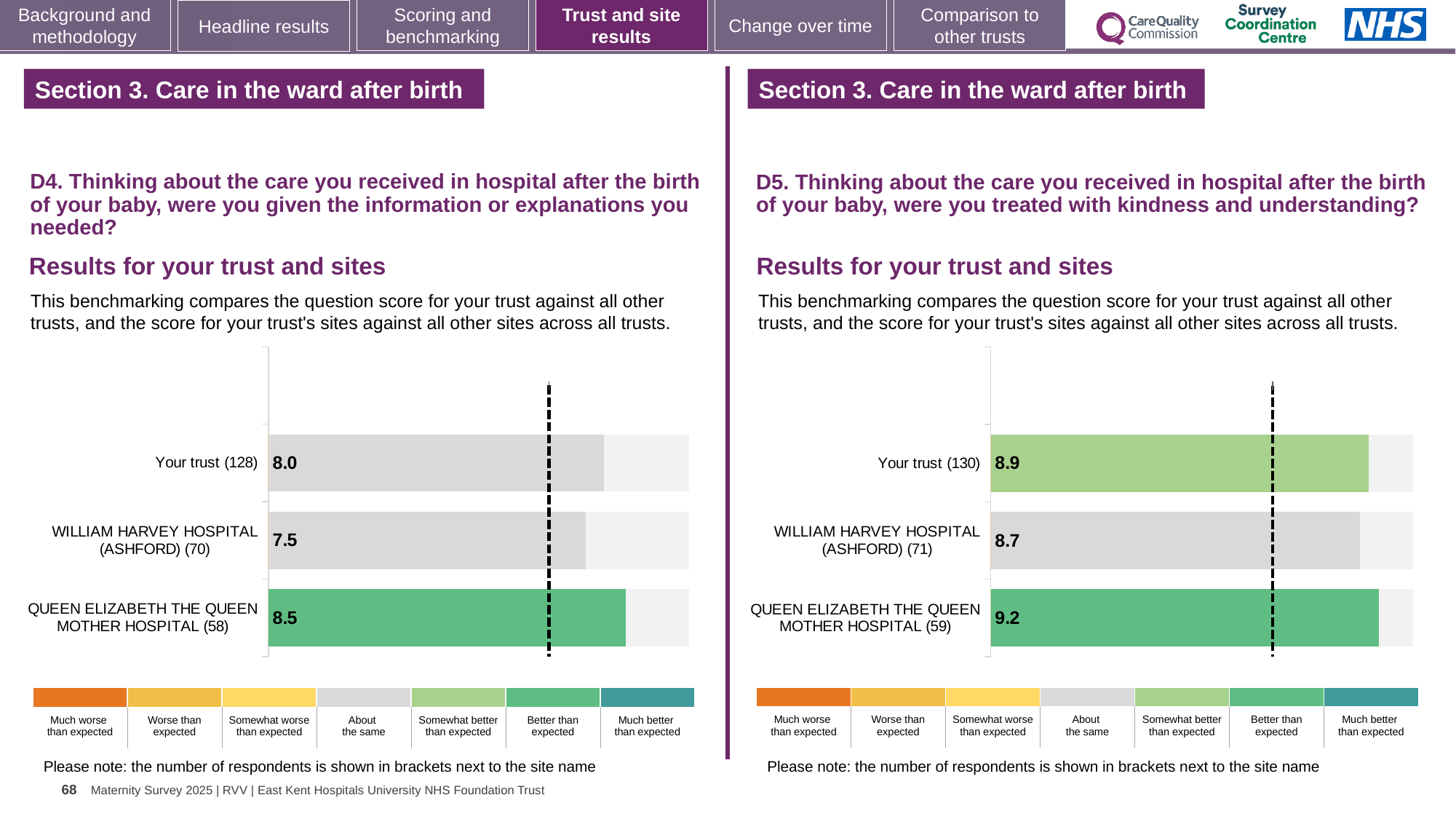
In the D4 chart on the left, what is the score for WILLIAM HARVEY HOSPITAL (ASHFORD) (70)? 7.5 In the D4 chart on the left, what is the difference between the scores for QUEEN ELIZABETH THE QUEEN MOTHER HOSPITAL (58) and WILLIAM HARVEY HOSPITAL (ASHFORD) (70)? 1.0 In the D4 chart on the left, which site or trust has the lowest score? WILLIAM HARVEY HOSPITAL (ASHFORD) (70) In the D4 chart on the left, what is the score for Your trust (128)? 8.0 What type of chart is used in the D5 chart on the right? Bar chart In the D5 chart on the right, what is the score for QUEEN ELIZABETH THE QUEEN MOTHER HOSPITAL (59)? 9.2 How many bars are shown in the D4 chart on the left? 3 In the D5 chart on the right, which site or trust has the lowest score? WILLIAM HARVEY HOSPITAL (ASHFORD) (71) In the D5 chart on the right, which is larger: the score for Your trust (130) or the score for WILLIAM HARVEY HOSPITAL (ASHFORD) (71)? Your trust (130) In the D5 chart on the right, what is the difference between the scores for QUEEN ELIZABETH THE QUEEN MOTHER HOSPITAL (59) and Your trust (130)? 0.3 In the D4 chart on the left, which site or trust has the highest score? QUEEN ELIZABETH THE QUEEN MOTHER HOSPITAL (58) In the D5 chart on the right, what is the score for Your trust (130)? 8.9